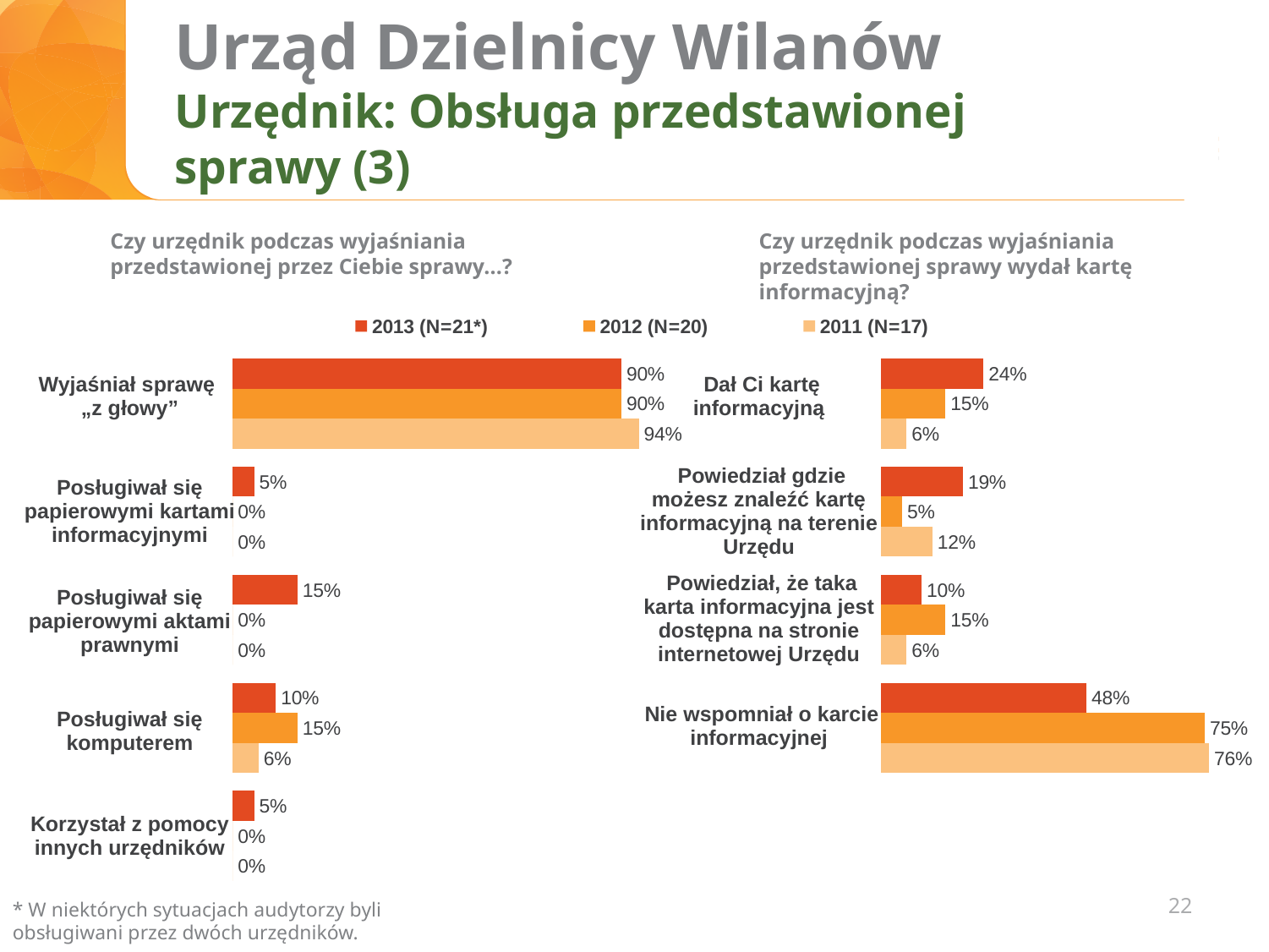
In the right chart, which category has the lowest 2013 value? Powiedział, że taka karta informacyjna jest dostępna na stronie internetowej Urzędu How many series does the legend list? 3 In the right chart ("Czy urzędnik podczas wyjaśniania przedstawionej sprawy wydał kartę informacyjną?"), what is the 2012 value for "Nie wspomniał o karcie informacyjnej"? 75% What type of chart is used on the slide? Bar chart In the right chart, what is the difference between the 2011 and 2013 values for "Nie wspomniał o karcie informacyjnej"? 28% In the left chart, how many categories are shown? 5 In the left chart, what is the 2011 value for "Posługiwał się komputerem"? 6% In the right chart, what is the 2013 value for "Dał Ci kartę informacyjną"? 24% In the left chart ("Czy urzędnik podczas wyjaśniania przedstawionej przez Ciebie sprawy...?"), what is the 2013 value for "Wyjaśniał sprawę „z głowy”"? 90% In the left chart, which category has the highest 2011 value? Wyjaśniał sprawę „z głowy” In the right chart, which is larger for "Powiedział gdzie możesz znaleźć kartę informacyjną na terenie Urzędu": the 2013 value or the 2012 value? 2013 In the left chart, what is the 2013 value for "Posługiwał się papierowymi aktami prawnymi"? 15%